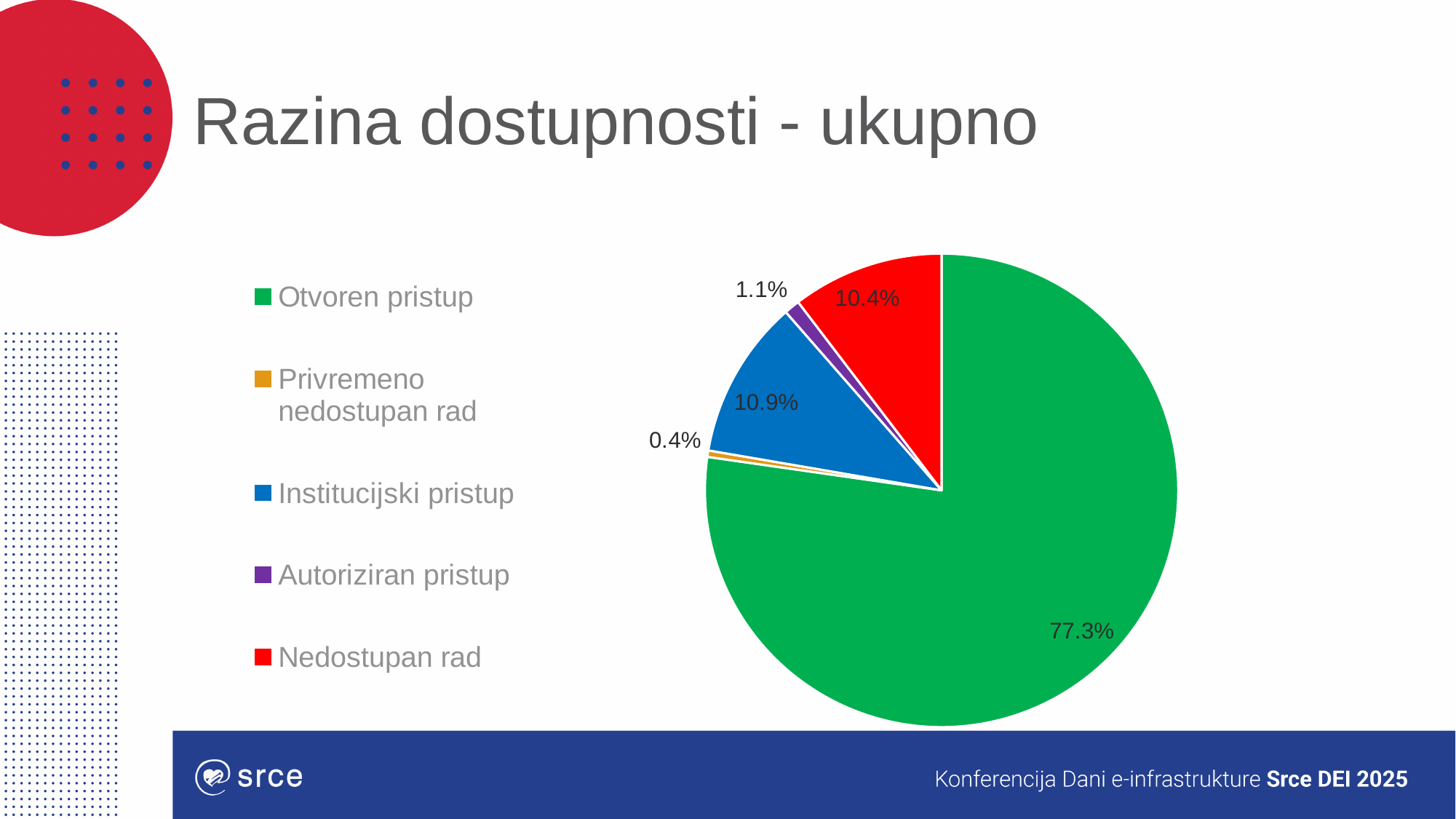
What colour is the slice for Nedostupan rad? red What is the value for Autoriziran pristup? 1.1% How many categories does the pie chart have? 5 What share of the pie does Otvoren pristup have? 77.3% What is the value for Privremeno nedostupan rad? 0.4% Which category has the largest slice of the pie? Otvoren pristup Which category has the smallest slice of the pie? Privremeno nedostupan rad What is the difference between the values for Institucijski pristup and Nedostupan rad? 0.5% What is the value for Nedostupan rad? 10.4% What is the value for Institucijski pristup? 10.9% What kind of chart is shown on the slide? pie chart Which is larger, the value for Autoriziran pristup or the value for Privremeno nedostupan rad? Autoriziran pristup